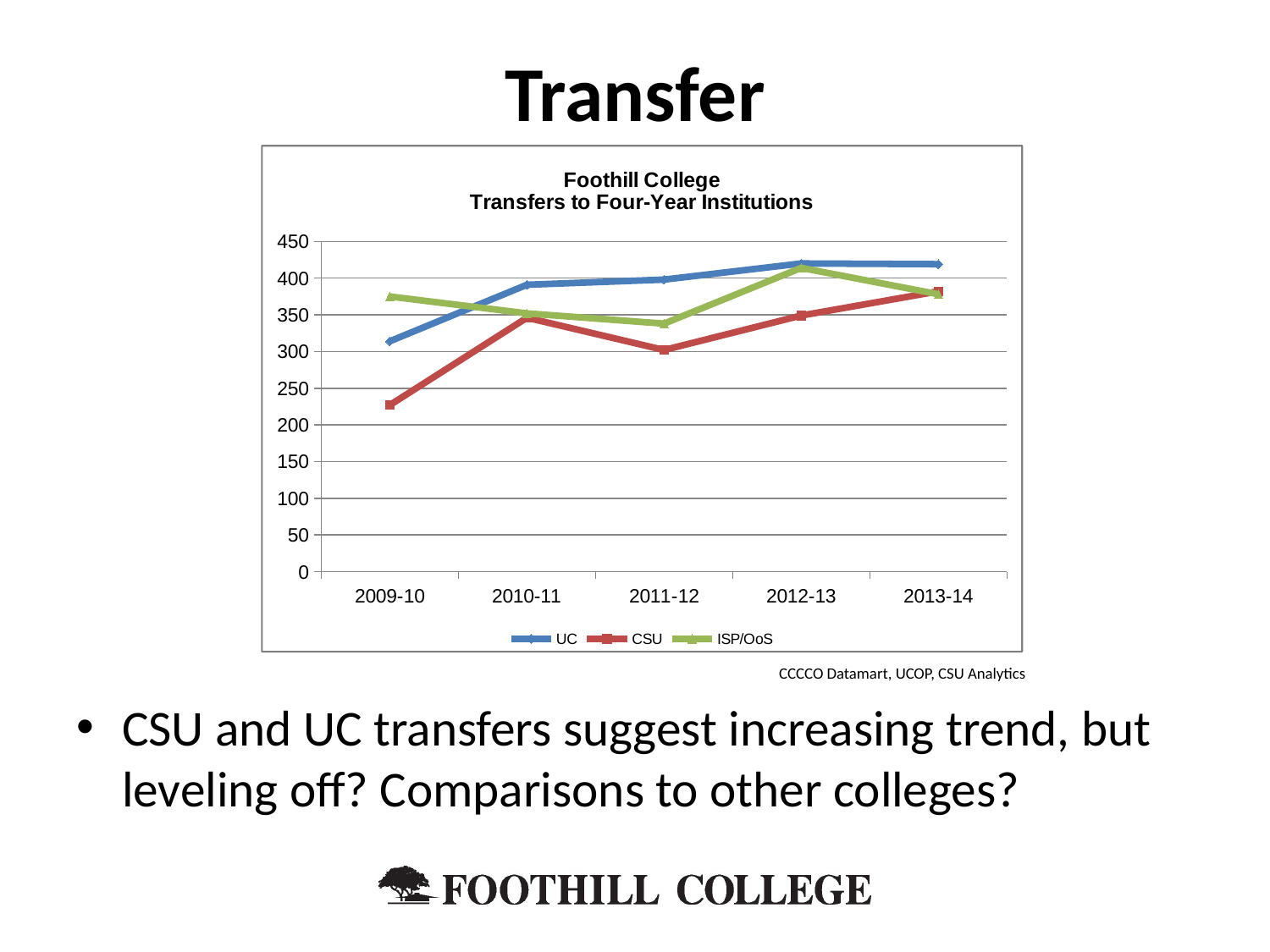
What is the title of the chart? Foothill College Transfers to Four-Year Institutions What kind of chart is shown on the slide? line chart Is the value for CSU in 2011-12 greater or less than 350? less Does the UC line rise or fall from 2009-10 to 2012-13? rise In which year is the CSU value lowest? 2009-10 Is the value for UC in 2009-10 greater or less than 350? less Is the value for CSU in 2009-10 greater or less than 250? less How many series does the legend list? 3 Which series is drawn in green in the legend? ISP/OoS How many academic years are plotted on the x axis? 5 In 2009-10, which is larger, the UC value or the CSU value? UC